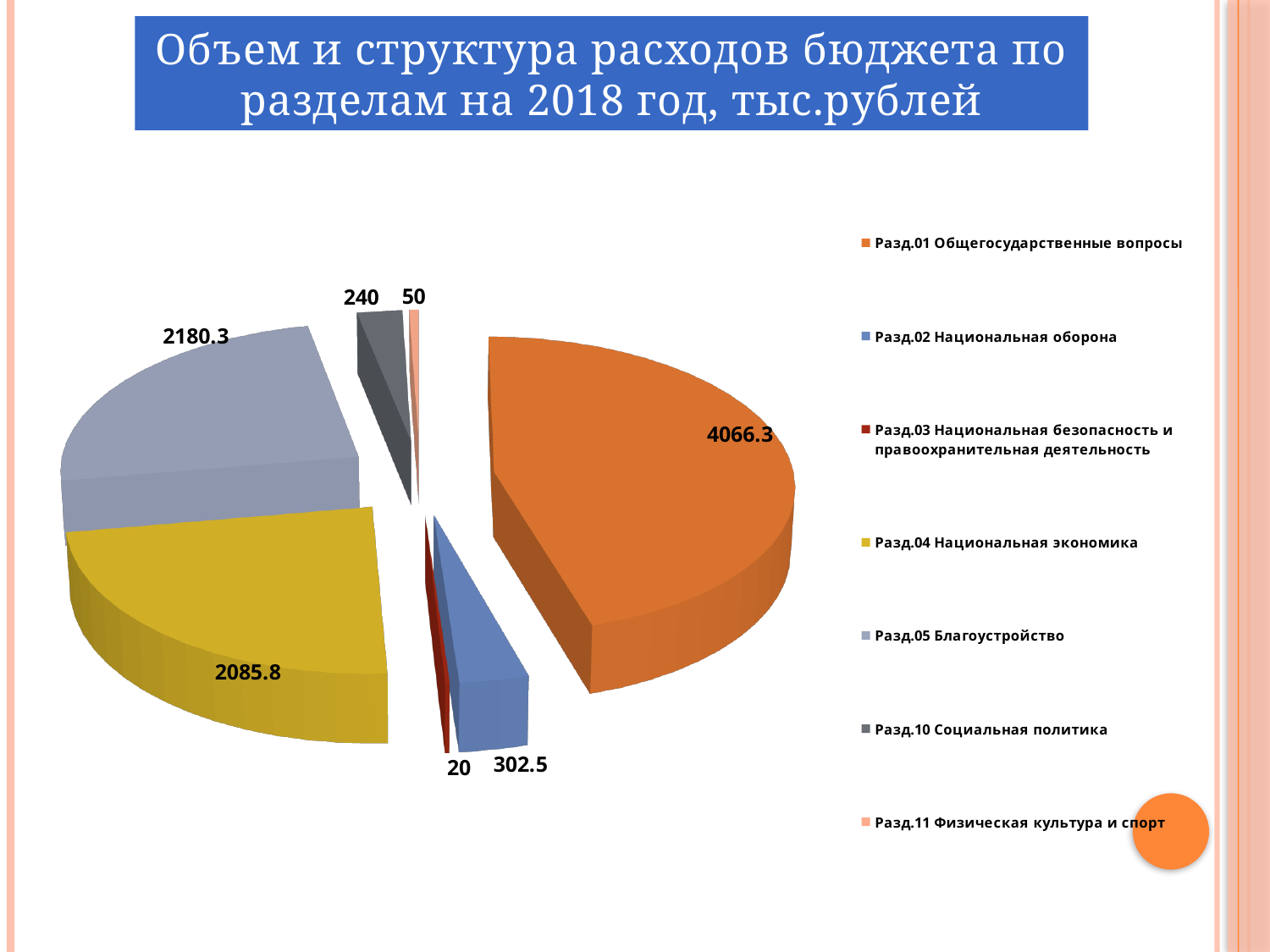
Which section has the smallest value? Разд.03 Национальная безопасность и правоохранительная деятельность Which is larger: the value for Разд.10 Социальная политика or Разд.11 Физическая культура и спорт? Разд.10 Социальная политика What is the difference between the values for Разд.05 Благоустройство and Разд.04 Национальная экономика? 94.5 How many sections (slices) does the pie chart show? 7 What is the value for Разд.02 Национальная оборона? 302.5 What is the value for Разд.05 Благоустройство? 2180.3 Which section has the largest value? Разд.01 Общегосударственные вопросы What is the difference between the values for Разд.02 Национальная оборона and Разд.10 Социальная политика? 62.5 What is the value for Разд.04 Национальная экономика? 2085.8 What colour is the slice for Разд.04 Национальная экономика? Yellow What is the value for Разд.01 Общегосударственные вопросы? 4066.3 What type of chart is shown on the slide? Pie chart